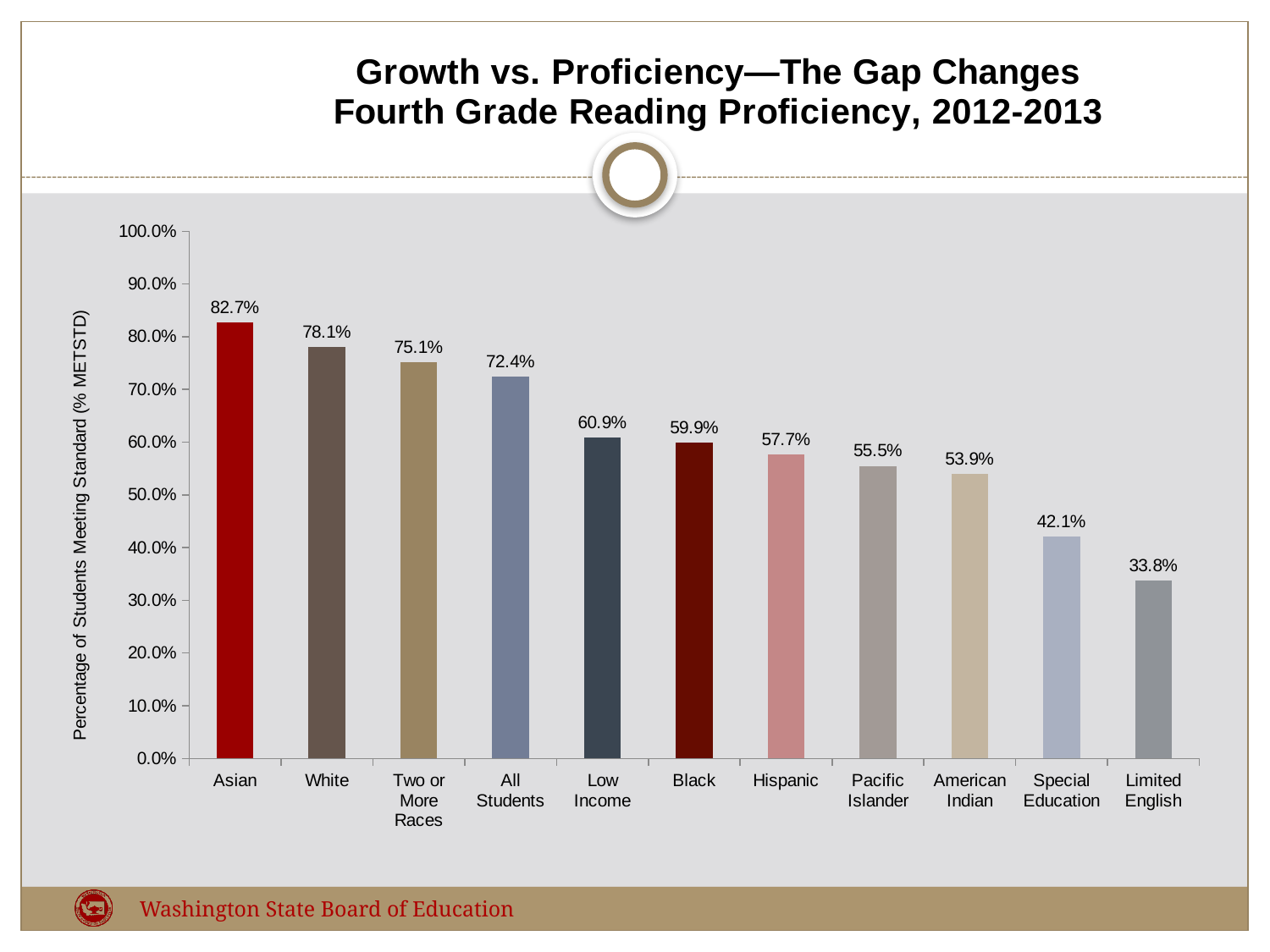
What is the percentage of students meeting standard for Asian students? 82.7% Which is larger, the value for Low Income or the value for Hispanic? Low Income What is the percentage of students meeting standard for Special Education students? 42.1% What is the percentage of students meeting standard for All Students? 72.4% Which category has the highest percentage of students meeting standard? Asian How many categories are shown on the x axis? 11 Do the values rise or fall moving from left to right along the x axis? fall What kind of chart is shown on the slide? bar chart What is the difference between the percentages for White and Black students? 18.2% Is the value for American Indian greater or less than 50.0%? greater Which category has the lowest percentage of students meeting standard? Limited English What is the label of the y axis? Percentage of Students Meeting Standard (% METSTD)